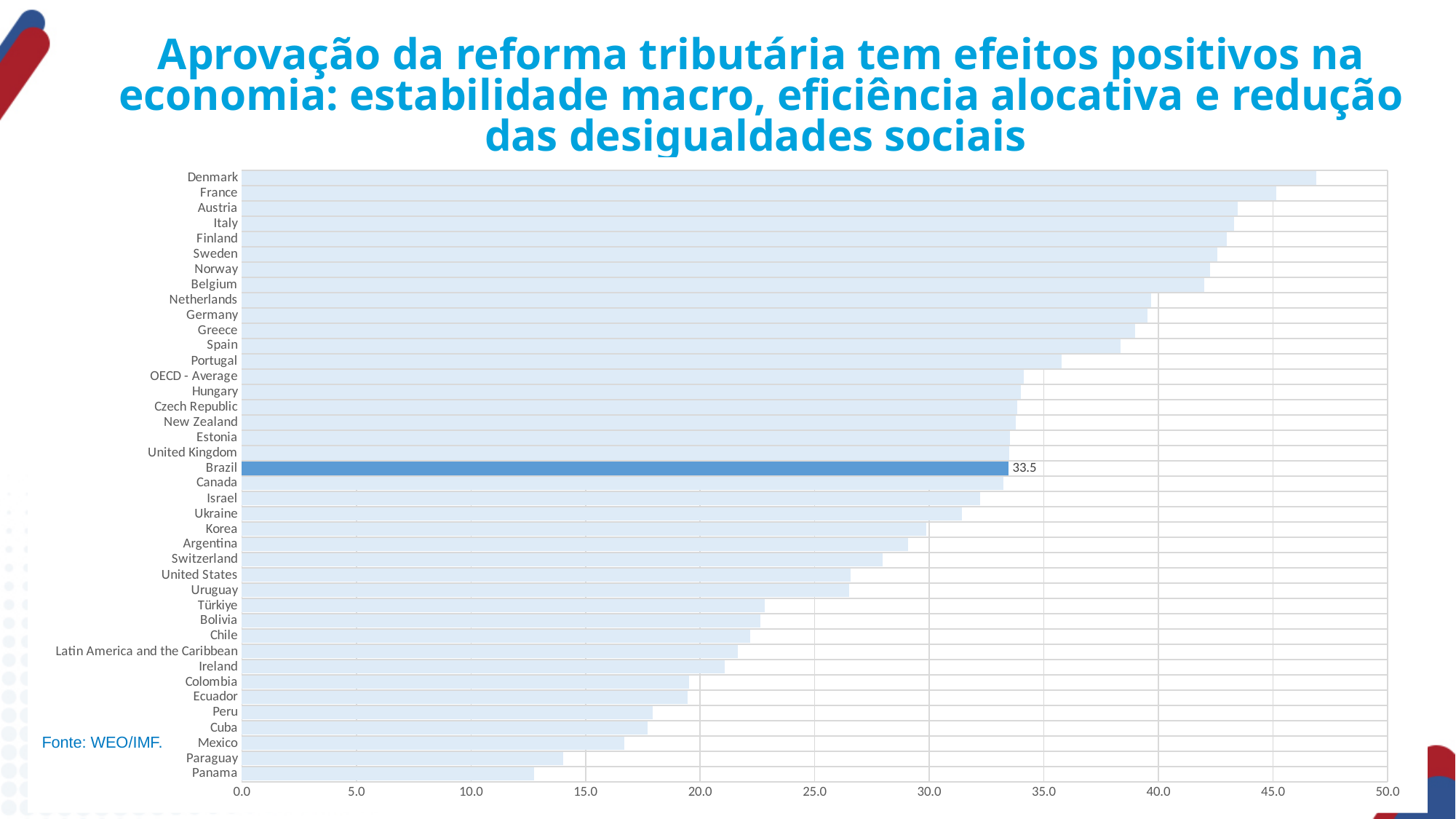
Which country has the lowest value in the chart? Panama Which has a larger value, Brazil or United States? Brazil Is the value for Switzerland greater or less than 30.0? less Is the value for Colombia greater or less than 20.0? less Is the value for United States greater or less than 25.0? greater Which has a larger value, Germany or Mexico? Germany How many categories (bars) are shown in the chart? 40 Which country has the highest value in the chart? Denmark What value is shown for Brazil? 33.5 What kind of chart is shown on the slide? Bar chart